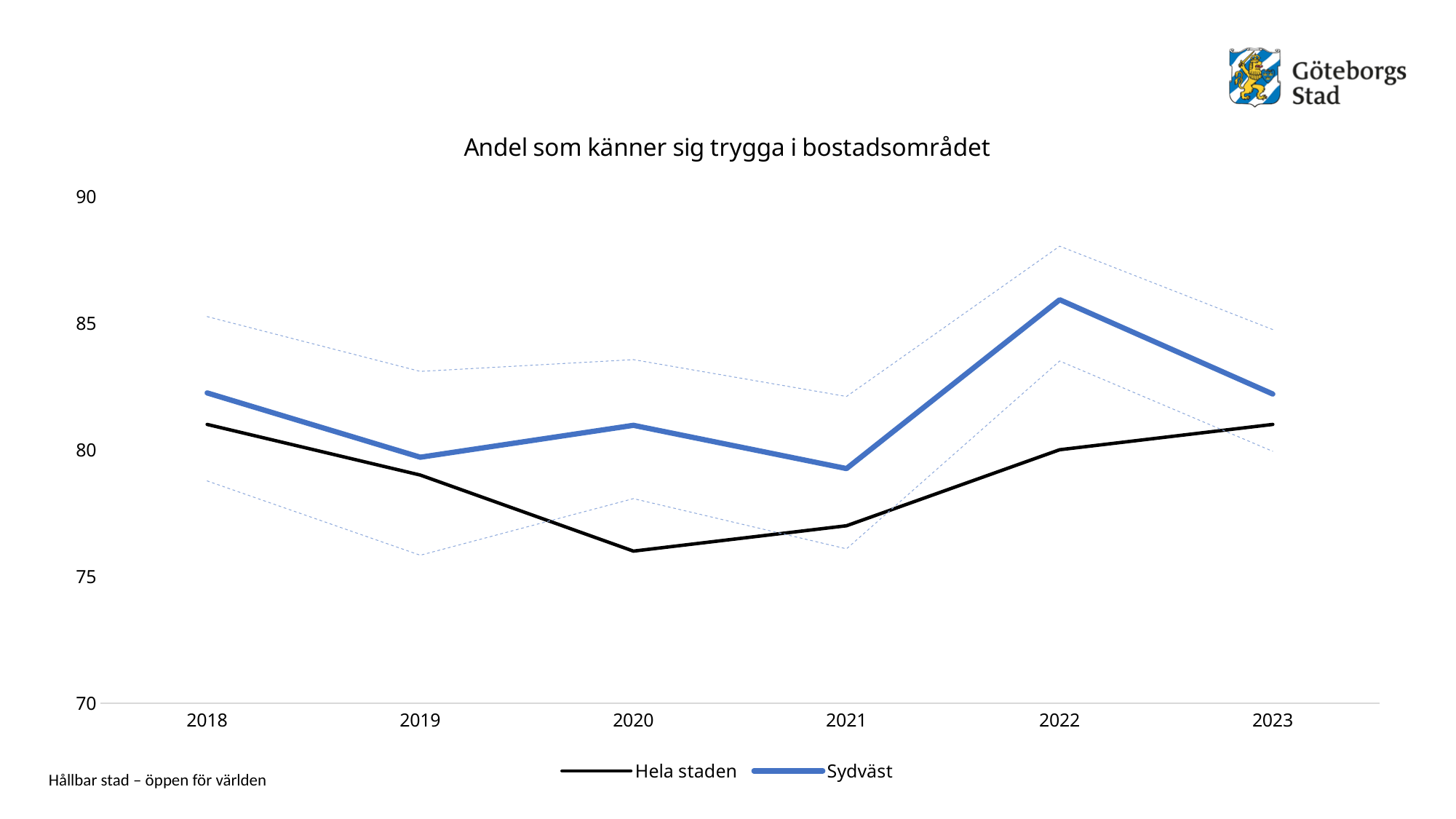
In which year does Sydväst reach its highest value? 2022 How many years are shown on the x axis? 6 Is the value for Sydväst in 2022 greater or less than 85? greater Is the value for Hela staden in 2020 greater or less than 80? less In which year does Hela staden have its lowest value? 2020 Which series is drawn with the blue line? Sydväst Is the value for Hela staden in 2018 greater or less than 80? greater What is the title of the chart? Andel som känner sig trygga i bostadsområdet How many series does the legend list? 2 What kind of chart is shown on the slide? line chart In 2022, which series has the higher value, Hela staden or Sydväst? Sydväst Does the Hela staden line rise or fall from 2020 to 2023? rise